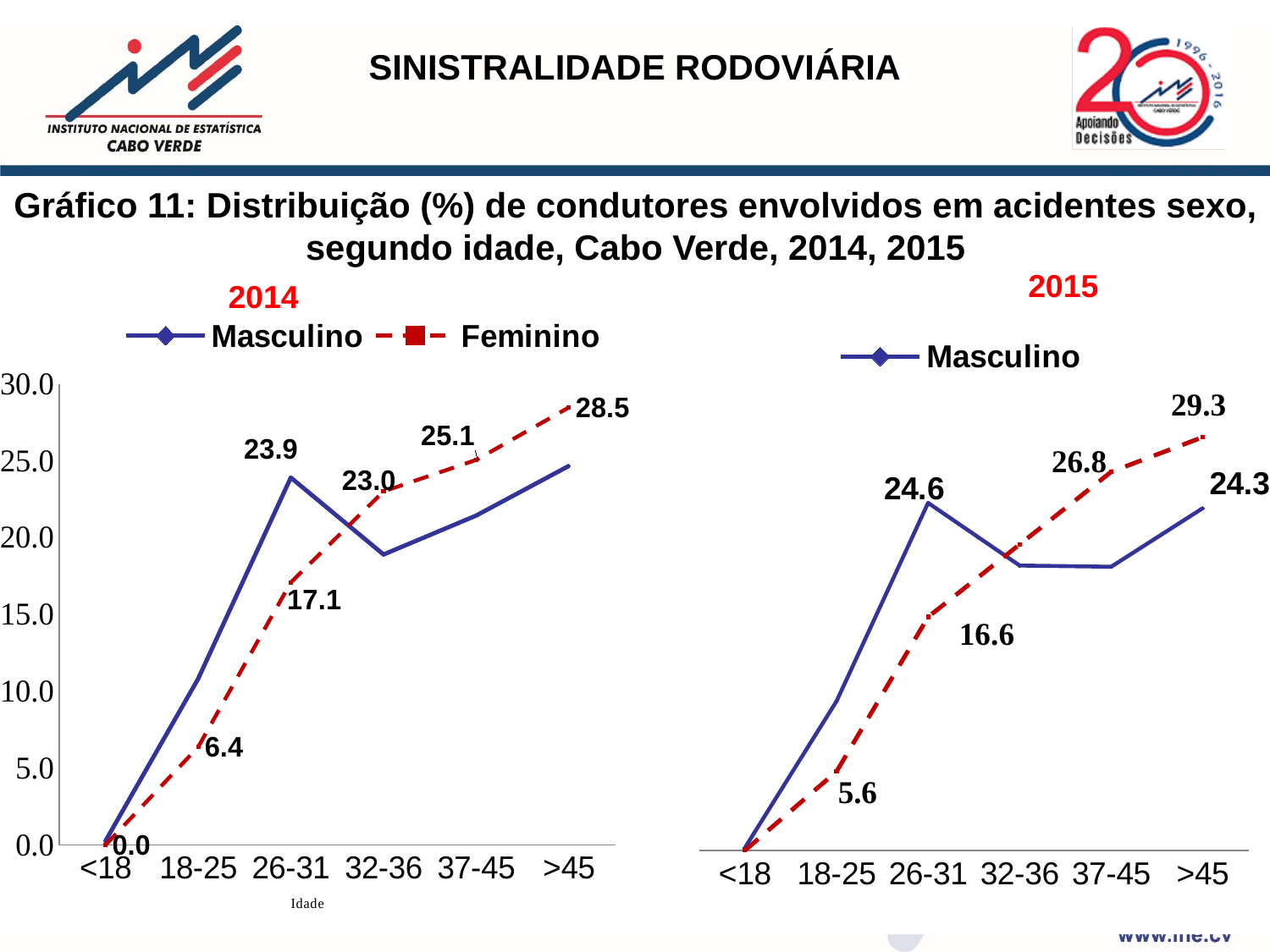
In the 2015 chart, what value is labelled on the red dashed line for the >45 age group? 29.3 How many age categories are shown on the x axis of the 2014 chart? 6 In the 2014 chart, what is the difference between the Feminino values for >45 and 26-31? 11.4 In the 2014 chart, what is the Masculino value for the 26-31 age group? 23.9 In the 2015 chart, what is the Masculino value for the 26-31 age group? 24.6 In the 2014 chart, does the Feminino line rise or fall as age increases along the x axis? Rises In the 2014 chart, which age group has the highest Feminino value? >45 How many series does the legend of the 2014 chart list? 2 In the 2014 chart, which series has the larger value at 26-31, Masculino or Feminino? Masculino In the 2014 chart, what is the Feminino value for the 18-25 age group? 6.4 What kind of chart is used for the 2014 data on the left? Line chart In the 2014 chart, what is the Feminino value for the >45 age group? 28.5